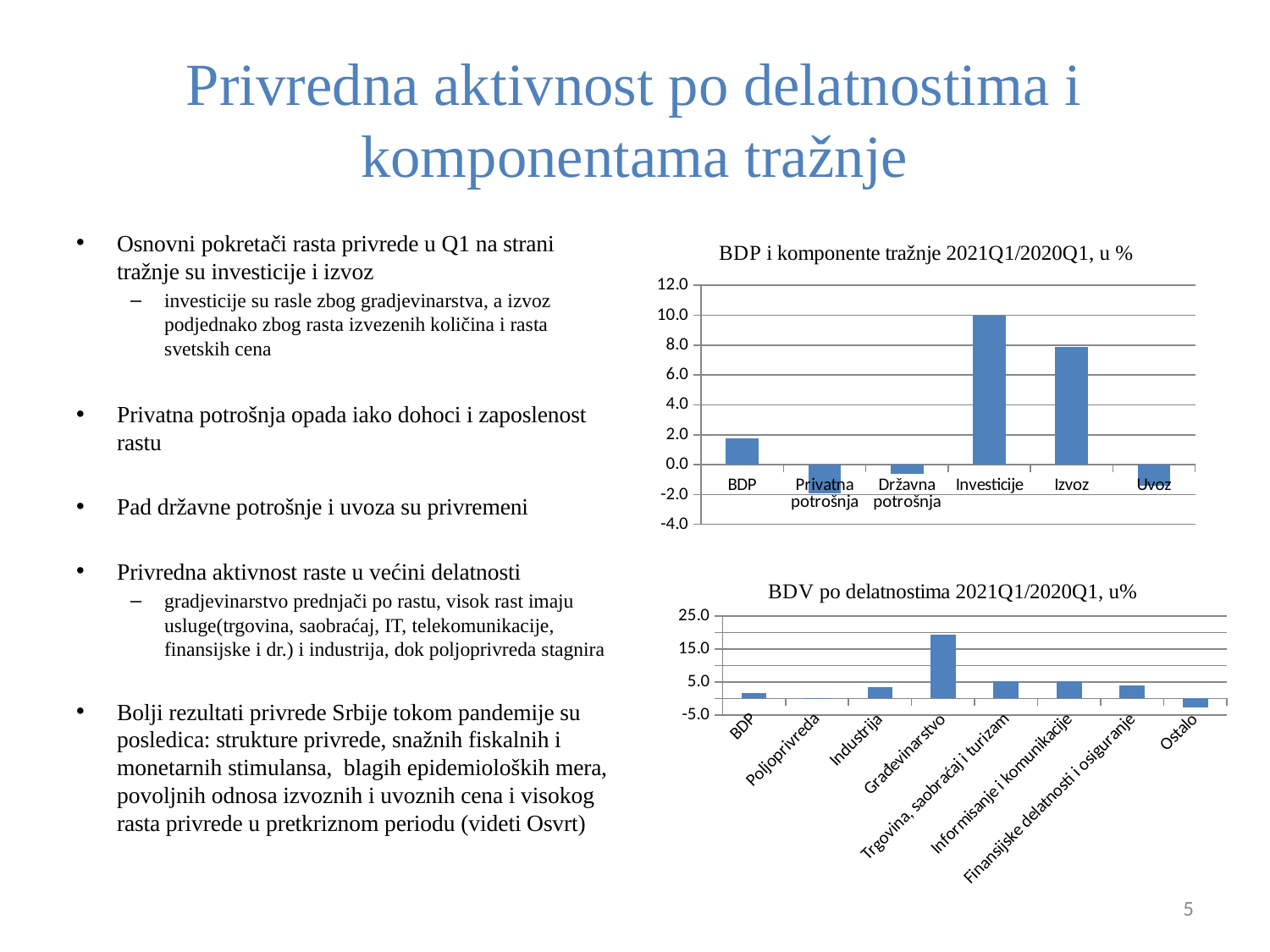
What type of chart is the bottom chart 'BDV po delatnostima 2021Q1/2020Q1, u%'? bar chart In the top chart 'BDP i komponente tražnje 2021Q1/2020Q1, u %', is the value for Investicije greater or less than 8.0? greater In the top chart 'BDP i komponente tražnje 2021Q1/2020Q1, u %', which category has the lowest value? Privatna potrošnja In the top chart 'BDP i komponente tražnje 2021Q1/2020Q1, u %', which category has the highest value? Investicije How many categories are shown in the top chart 'BDP i komponente tražnje 2021Q1/2020Q1, u %'? 6 In the bottom chart 'BDV po delatnostima 2021Q1/2020Q1, u%', which category has the lowest value? Ostalo In the top chart 'BDP i komponente tražnje 2021Q1/2020Q1, u %', is the value for Uvoz greater or less than 0.0? less In the bottom chart 'BDV po delatnostima 2021Q1/2020Q1, u%', which category has the highest value? Građevinarstvo In the top chart 'BDP i komponente tražnje 2021Q1/2020Q1, u %', which is larger, the value for Investicije or the value for Izvoz? Investicije How many categories are shown in the bottom chart 'BDV po delatnostima 2021Q1/2020Q1, u%'? 8 In the bottom chart 'BDV po delatnostima 2021Q1/2020Q1, u%', is the value for Građevinarstvo greater or less than 15.0? greater